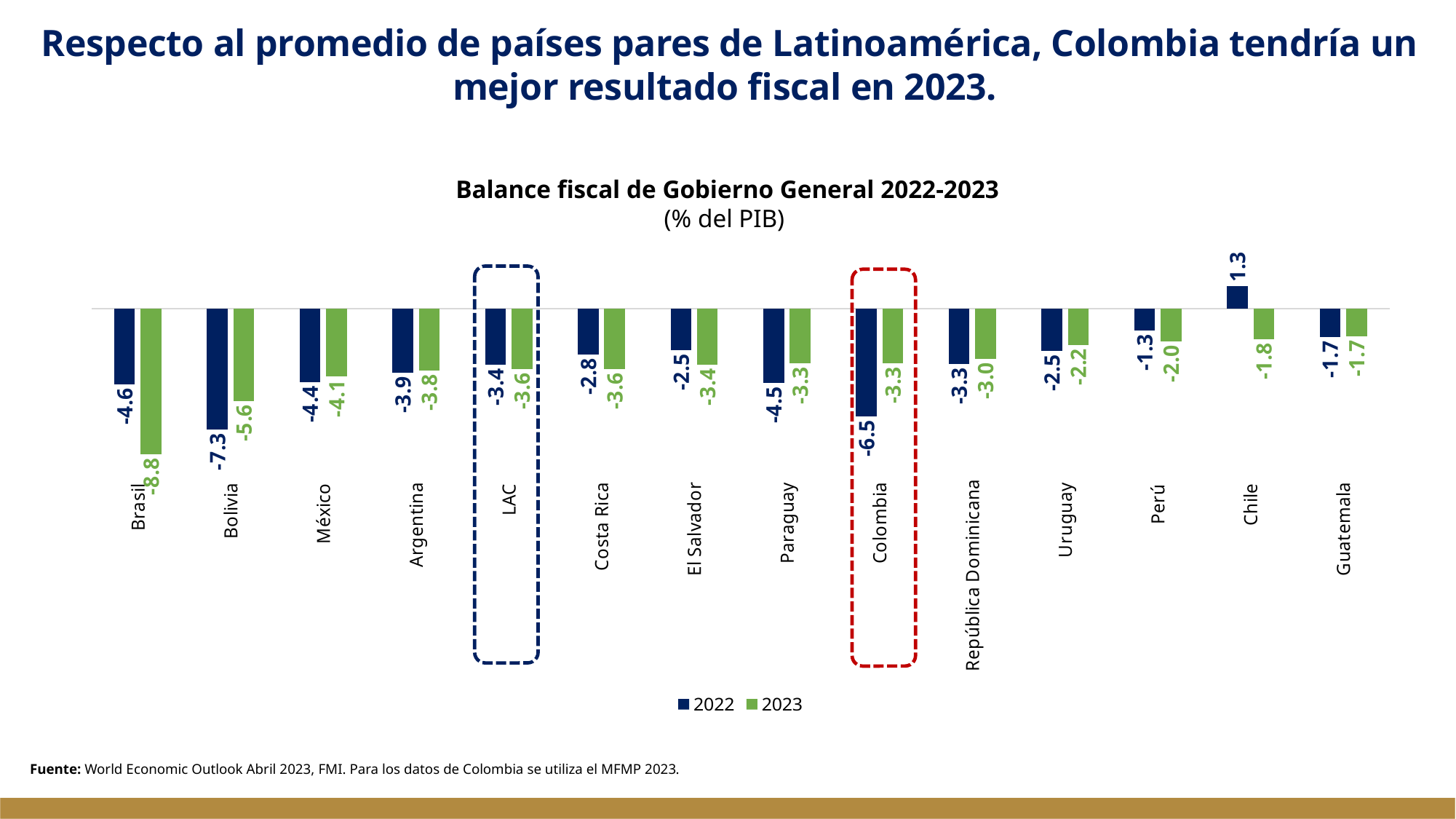
Which is larger, the 2023 value for Brasil or the 2023 value for Bolivia? Bolivia What is the 2023 value for LAC? -3.6 What is the 2022 value for Bolivia? -7.3 How many categories are shown on the x axis? 14 What is the difference between Colombia's 2022 value and its 2023 value? 3.2 Which category has the lowest 2023 value? Brasil What kind of chart is shown on the slide? Bar chart What is the 2023 value for Colombia? -3.3 What is the 2022 value for Chile? 1.3 How many series does the legend list? 2 Which category has the lowest 2022 value? Bolivia Which category has the highest 2022 value? Chile